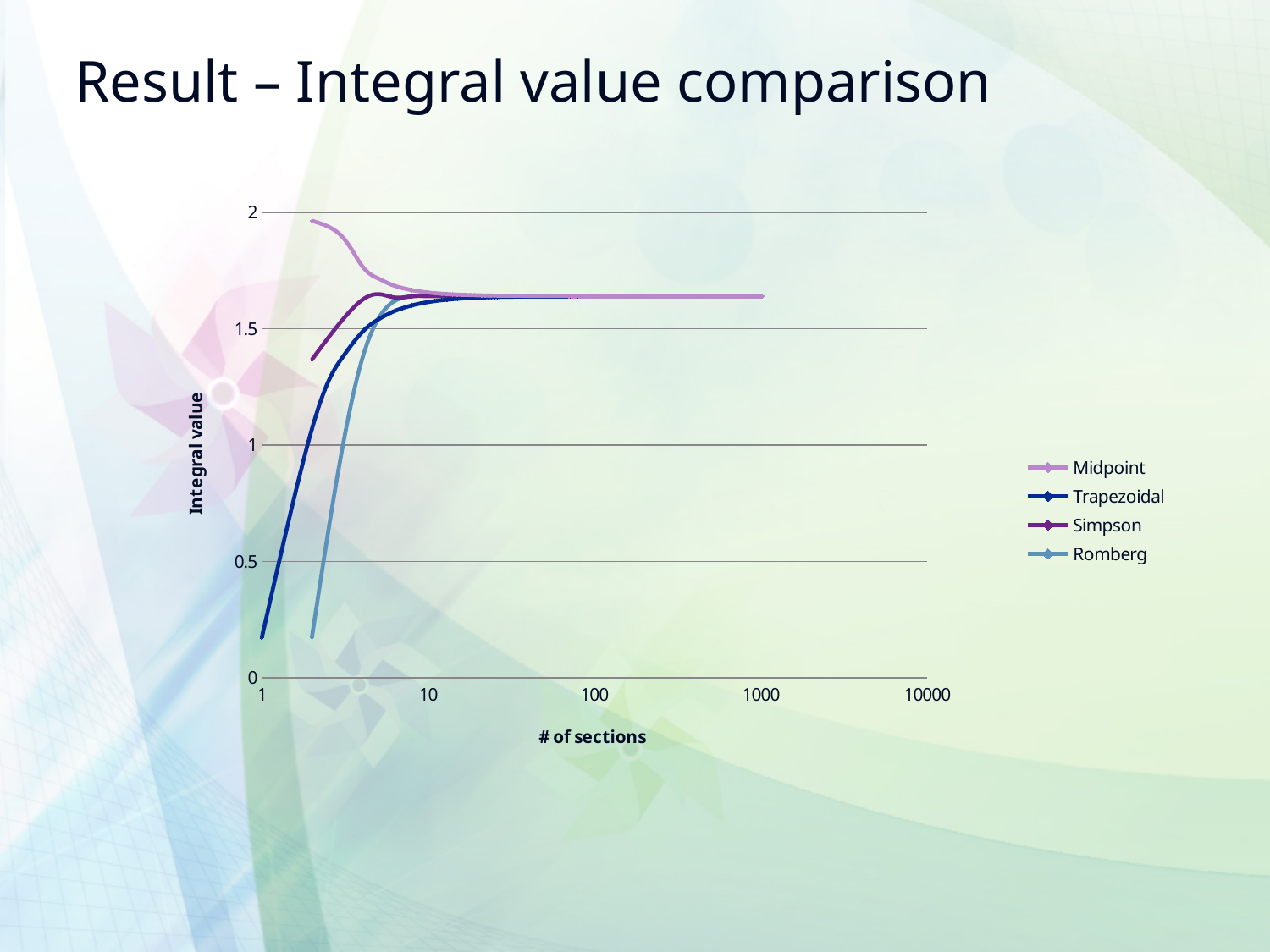
What is the title of the vertical axis? Integral value How many series does the legend list? 4 What kind of chart is shown on the slide? line chart Does the Midpoint series rise or fall as the number of sections increases? fall Is the first plotted value of the Midpoint series greater or less than 1.5? greater Which series are listed in the legend? Midpoint, Trapezoidal, Simpson, Romberg At their first plotted points, which series has the larger integral value, Midpoint or Simpson? Midpoint Does the Trapezoidal series rise or fall as the number of sections increases? rise Is the first plotted value of the Simpson series greater or less than 1? greater Is the first plotted value of the Trapezoidal series greater or less than 0.5? less Which series has the highest integral value at its first plotted point? Midpoint